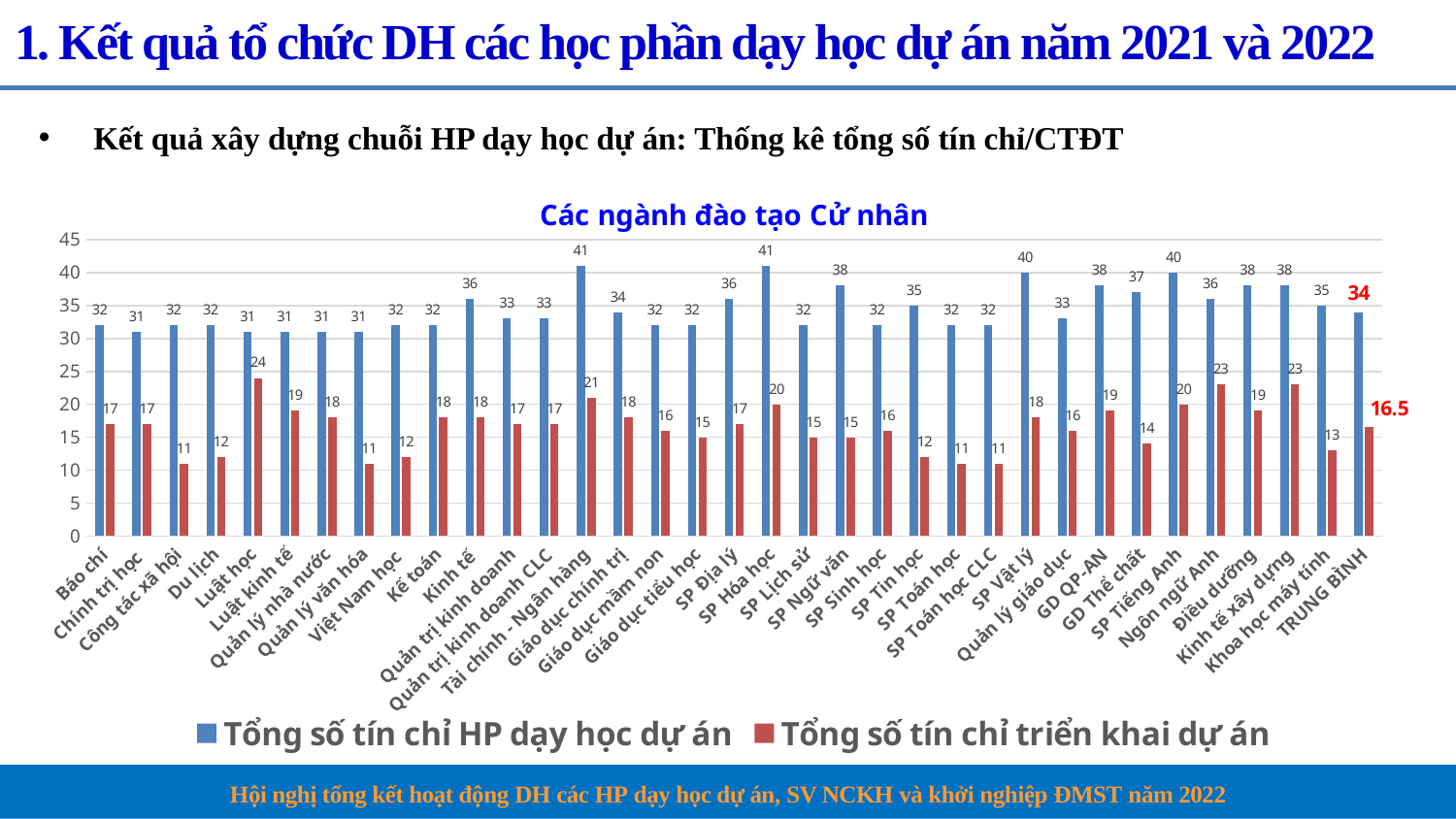
What kind of chart is shown on the slide? bar chart What is the value of 'Tổng số tín chỉ triển khai dự án' for Luật học? 24 How many categories are shown on the x axis of the chart? 35 What is the value of 'Tổng số tín chỉ triển khai dự án' for TRUNG BÌNH? 16.5 Is the value of 'Tổng số tín chỉ HP dạy học dự án' for SP Vật lý greater or less than 35? greater What is the value of 'Tổng số tín chỉ HP dạy học dự án' for Tài chính - Ngân hàng? 41 Which category has the highest value for 'Tổng số tín chỉ triển khai dự án'? Luật học Which has a larger value for 'Tổng số tín chỉ triển khai dự án': Ngôn ngữ Anh or Khoa học máy tính? Ngôn ngữ Anh What is the title of the chart? Các ngành đào tạo Cử nhân How many series does the legend list? 2 What is the value of 'Tổng số tín chỉ triển khai dự án' for GD Thể chất? 14 What is the difference between 'Tổng số tín chỉ HP dạy học dự án' and 'Tổng số tín chỉ triển khai dự án' for Tài chính - Ngân hàng? 20